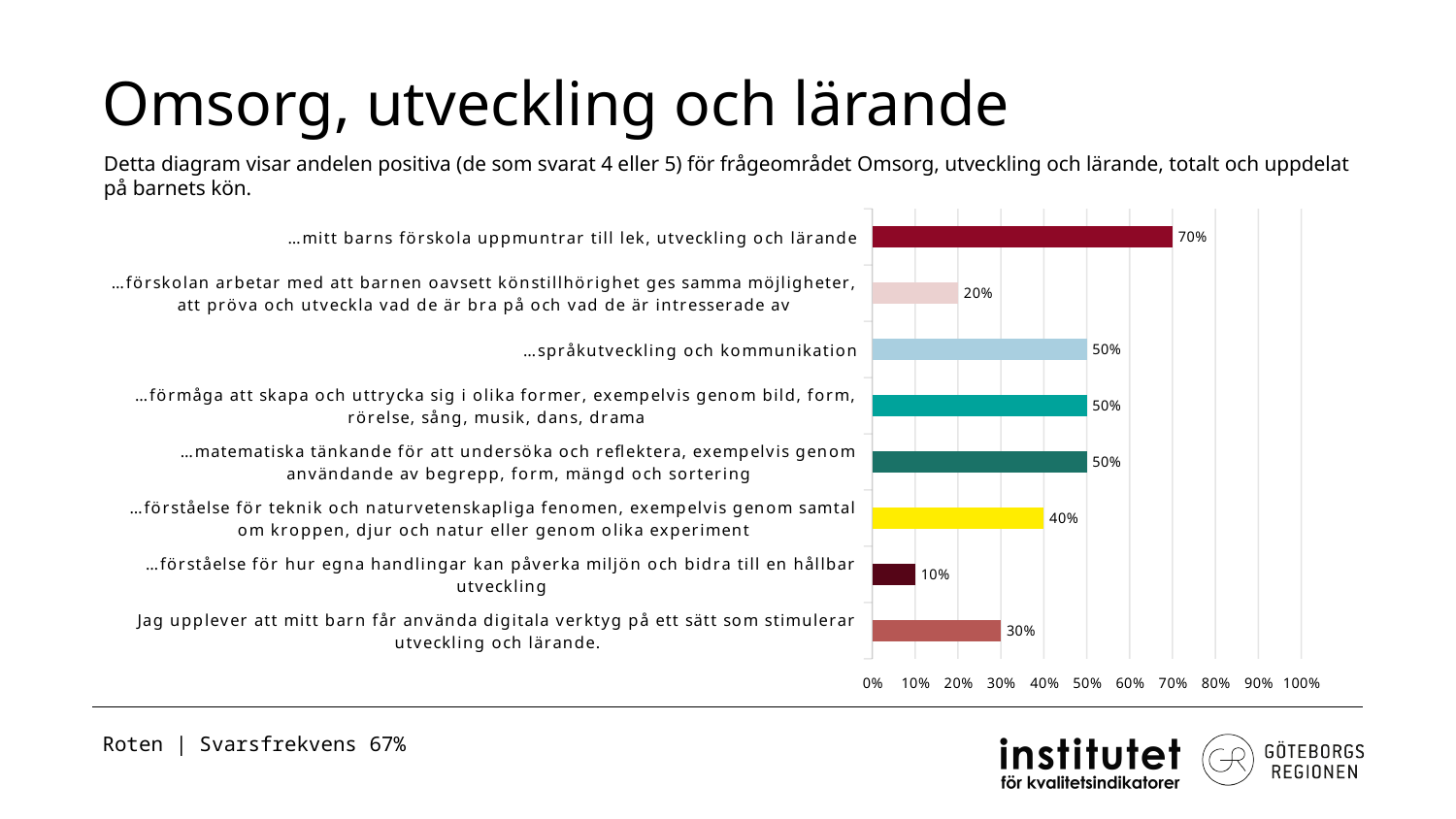
What is the difference between the value for "…mitt barns förskola uppmuntrar till lek, utveckling och lärande" and the value for "…förskolan arbetar med att barnen oavsett könstillhörighet ges samma möjligheter, att pröva och utveckla vad de är bra på och vad de är intresserade av"? 50% What is the title of the slide containing the chart? Omsorg, utveckling och lärande How many categories are shown in the chart? 8 What is the value for "…förståelse för hur egna handlingar kan påverka miljön och bidra till en hållbar utveckling"? 10% What is the value for "…språkutveckling och kommunikation"? 50% What is the value for "…mitt barns förskola uppmuntrar till lek, utveckling och lärande"? 70% What is the value for "Jag upplever att mitt barn får använda digitala verktyg på ett sätt som stimulerar utveckling och lärande."? 30% What kind of chart is shown on the slide? Bar chart Is the value for "…matematiska tänkande för att undersöka och reflektera, exempelvis genom användande av begrepp, form, mängd och sortering" greater or less than 40%? greater Which category has the highest value? …mitt barns förskola uppmuntrar till lek, utveckling och lärande Which category has the lowest value? …förståelse för hur egna handlingar kan påverka miljön och bidra till en hållbar utveckling Which is larger: the value for "…förståelse för teknik och naturvetenskapliga fenomen, exempelvis genom samtal om kroppen, djur och natur eller genom olika experiment" or the value for "Jag upplever att mitt barn får använda digitala verktyg på ett sätt som stimulerar utveckling och lärande."? …förståelse för teknik och naturvetenskapliga fenomen, exempelvis genom samtal om kroppen, djur och natur eller genom olika experiment